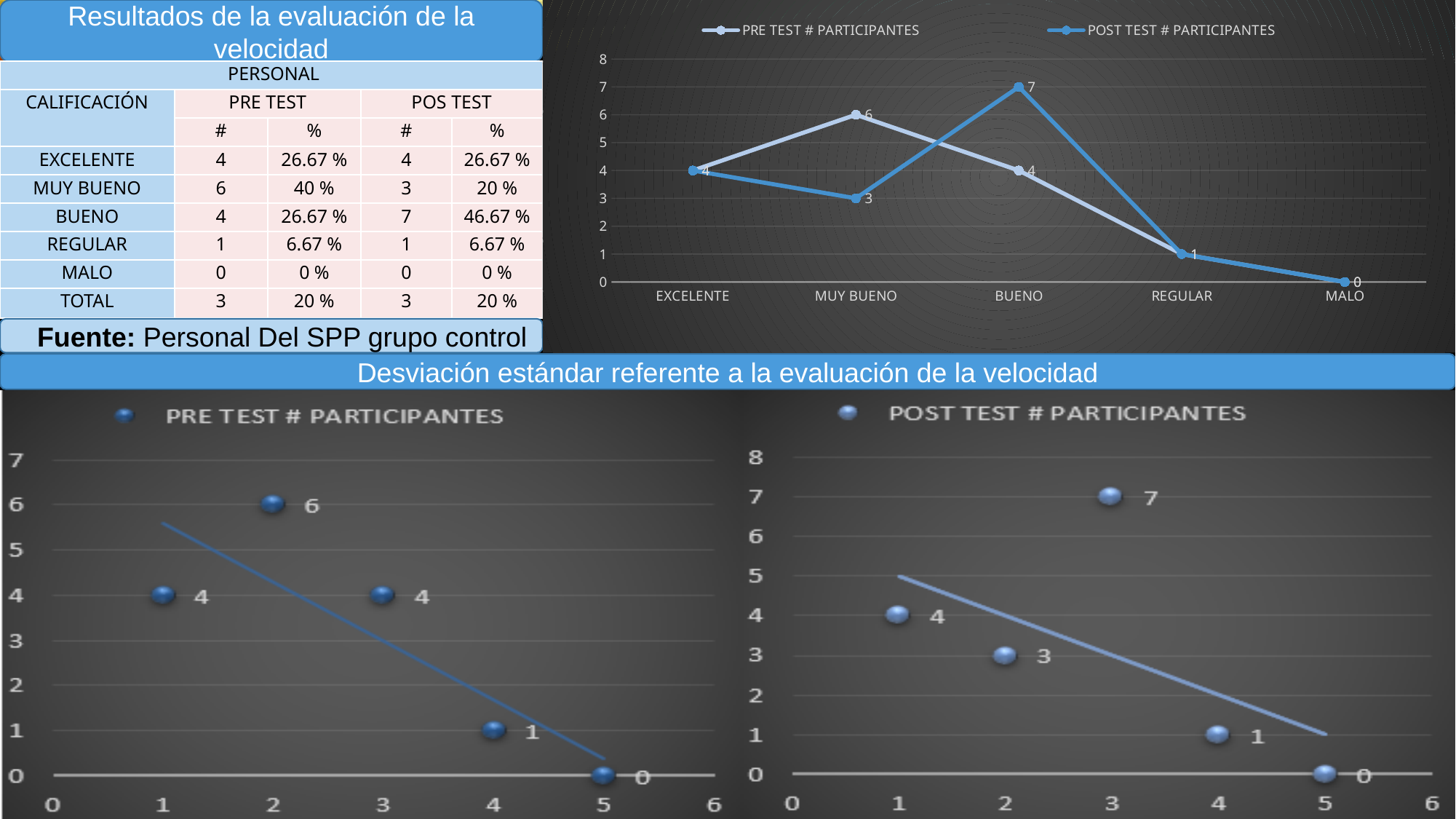
In the bottom-right POST TEST # PARTICIPANTES scatter chart, what is the value of the point at x = 3? 7 In the bottom-left PRE TEST # PARTICIPANTES scatter chart, what is the value of the point at x = 2? 6 What kind of chart is the top-right chart? Line chart In the top-right line chart, what is the POST TEST # PARTICIPANTES value for BUENO? 7 In the top-right line chart, what is the difference between the POST TEST and PRE TEST values for BUENO? 3 In the top-right line chart, which category has the highest POST TEST # PARTICIPANTES value? BUENO How many categories are shown on the x axis of the top-right line chart? 5 In the top-right line chart, which series has the larger value for MUY BUENO, PRE TEST or POST TEST? PRE TEST # PARTICIPANTES In the bottom-right POST TEST # PARTICIPANTES scatter chart, do the values generally rise or fall as x increases? Fall How many series does the legend of the top-right line chart list? 2 In the top-right line chart, which category has the lowest PRE TEST # PARTICIPANTES value? MALO In the top-right line chart, what is the PRE TEST # PARTICIPANTES value for MUY BUENO? 6